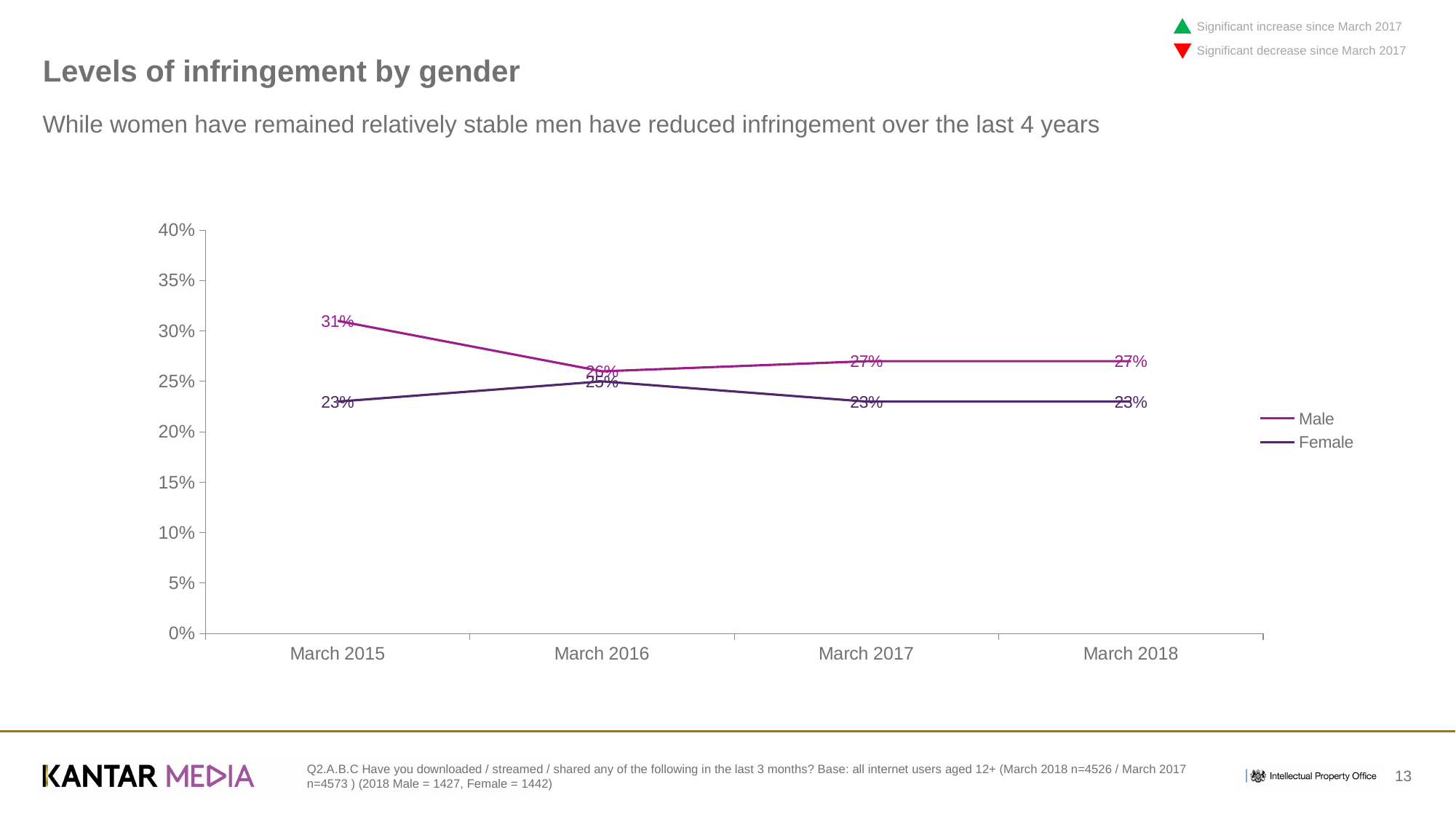
Which is larger in March 2018, the Male value or the Female value? Male What is the value for Male in March 2015? 31% What is the value for Female in March 2016? 25% What is the difference between the Male and Female values in March 2015? 8% What type of chart is shown on the slide? line chart In which year is the Male value highest? March 2015 What is the value for Male in March 2018? 27% What is the value for Female in March 2015? 23% How many series does the legend list? 2 What is the difference between the Male values in March 2015 and March 2018? 4% What is the value for Female in March 2017? 23% How many time points are shown on the x axis? 4